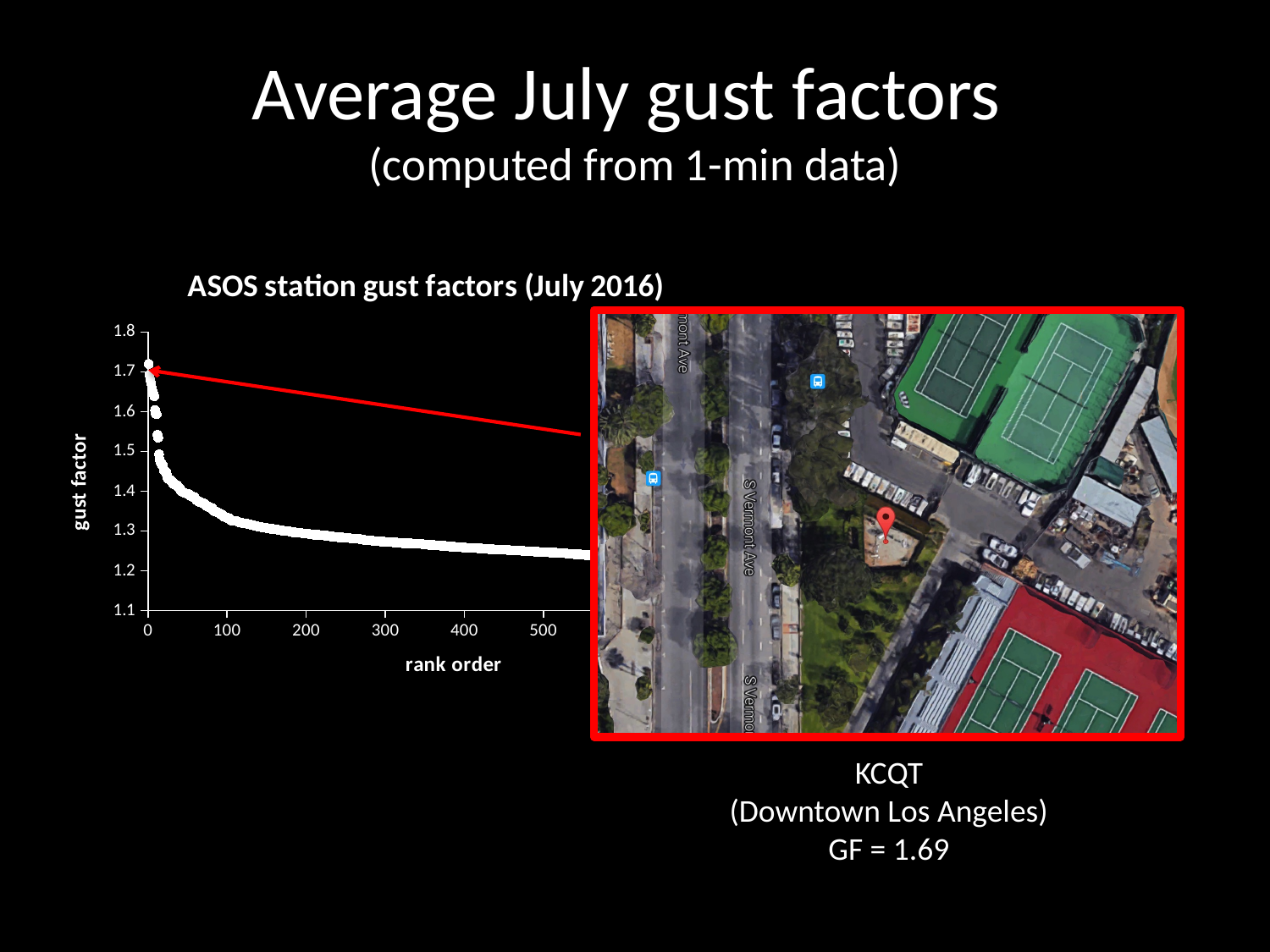
What is the title of the chart on the slide? ASOS station gust factors (July 2016) Do the gust factor values rise or fall as rank order increases along the x axis? fall Is the gust factor of the top-ranked station greater or less than 1.6? greater What kind of chart is shown on the slide? scatter chart Is the gust factor at rank order 100 greater or less than 1.4? less Is the gust factor at rank order 50 greater or less than 1.5? less What is the gust factor (GF) given for KCQT (Downtown Los Angeles)? 1.69 What is the label of the y axis of the chart? gust factor What is the lowest value shown on the y axis of the chart? 1.1